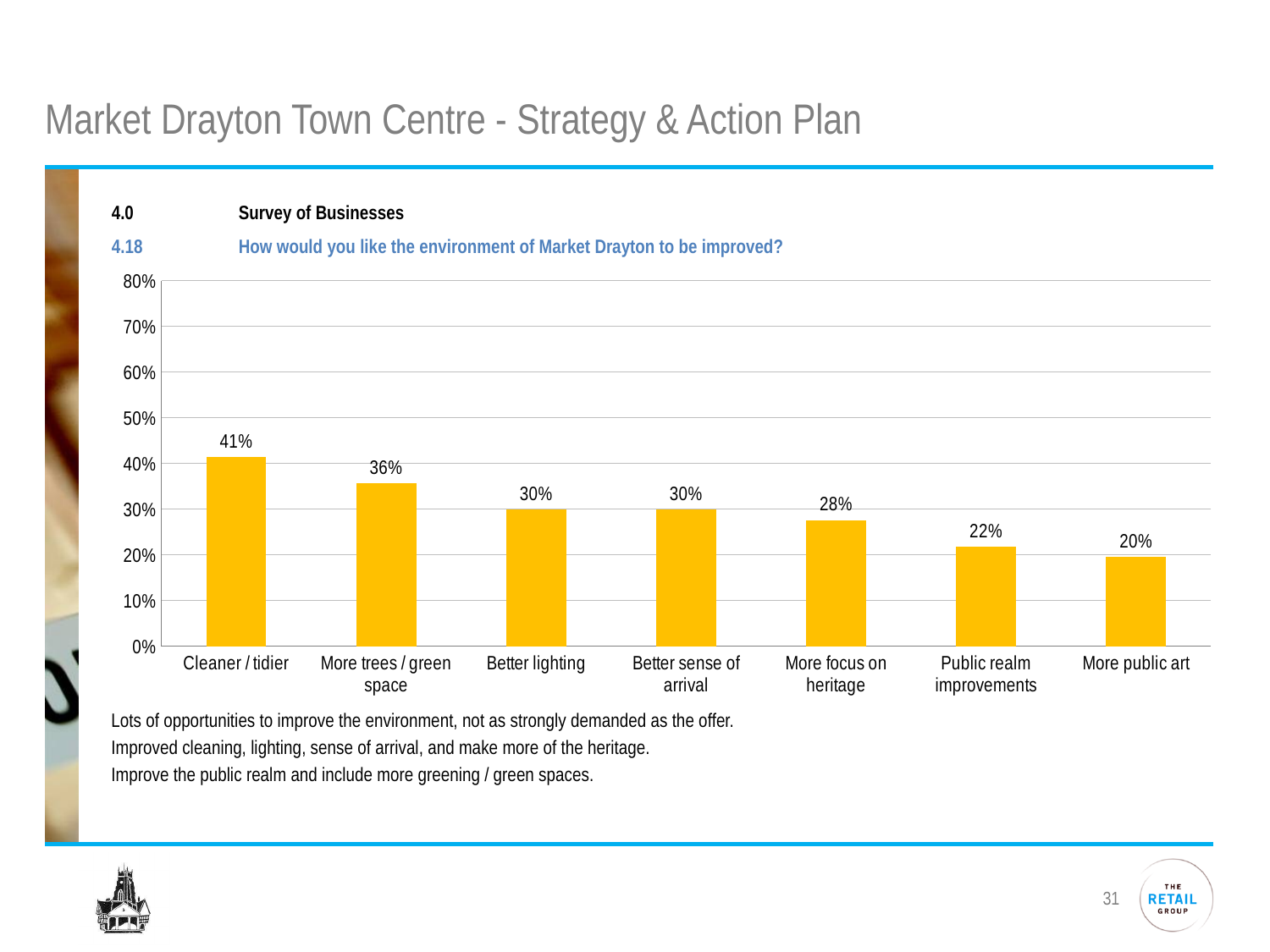
Is the value for 'More trees / green space' greater or less than 30%? greater What percentage of businesses chose 'Cleaner / tidier' as an environmental improvement? 41% Which improvement category has the lowest value? More public art What is the value shown for 'Public realm improvements'? 22% How many improvement categories are shown on the chart? 7 Do the values rise or fall moving from left to right across the categories? Fall What survey question does the chart present? How would you like the environment of Market Drayton to be improved? What is the value shown for 'More focus on heritage'? 28% What is the difference between the values for 'Cleaner / tidier' and 'More trees / green space'? 5% What kind of chart is used to show the survey responses? Bar chart Which is larger: the value for 'More focus on heritage' or the value for 'Public realm improvements'? More focus on heritage Which improvement category has the highest value? Cleaner / tidier